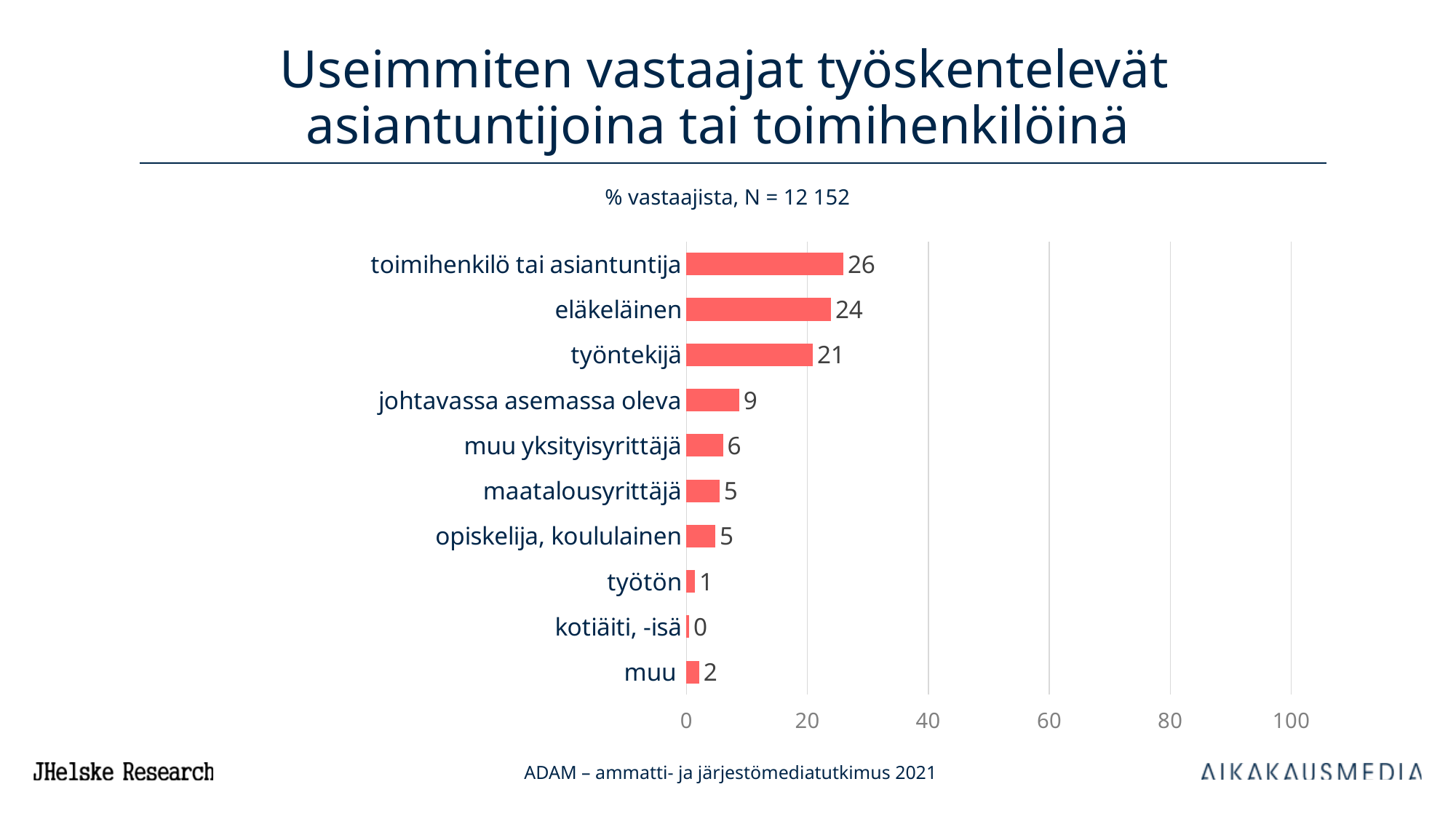
Is the value for "eläkeläinen" greater or less than 20? greater What is the highest tick value shown on the x axis? 100 What is the value for "johtavassa asemassa oleva"? 9 Which is larger, the value for "muu yksityisyrittäjä" or the value for "muu"? muu yksityisyrittäjä Which category has the lowest value? kotiäiti, -isä What kind of chart is shown on the slide? bar chart What is the value for "työtön"? 1 Which category has the highest value? toimihenkilö tai asiantuntija How many categories are shown in the chart? 10 What is the subtitle shown above the chart? % vastaajista, N = 12 152 What is the value for "eläkeläinen"? 24 What is the difference between the values for "toimihenkilö tai asiantuntija" and "työntekijä"? 5